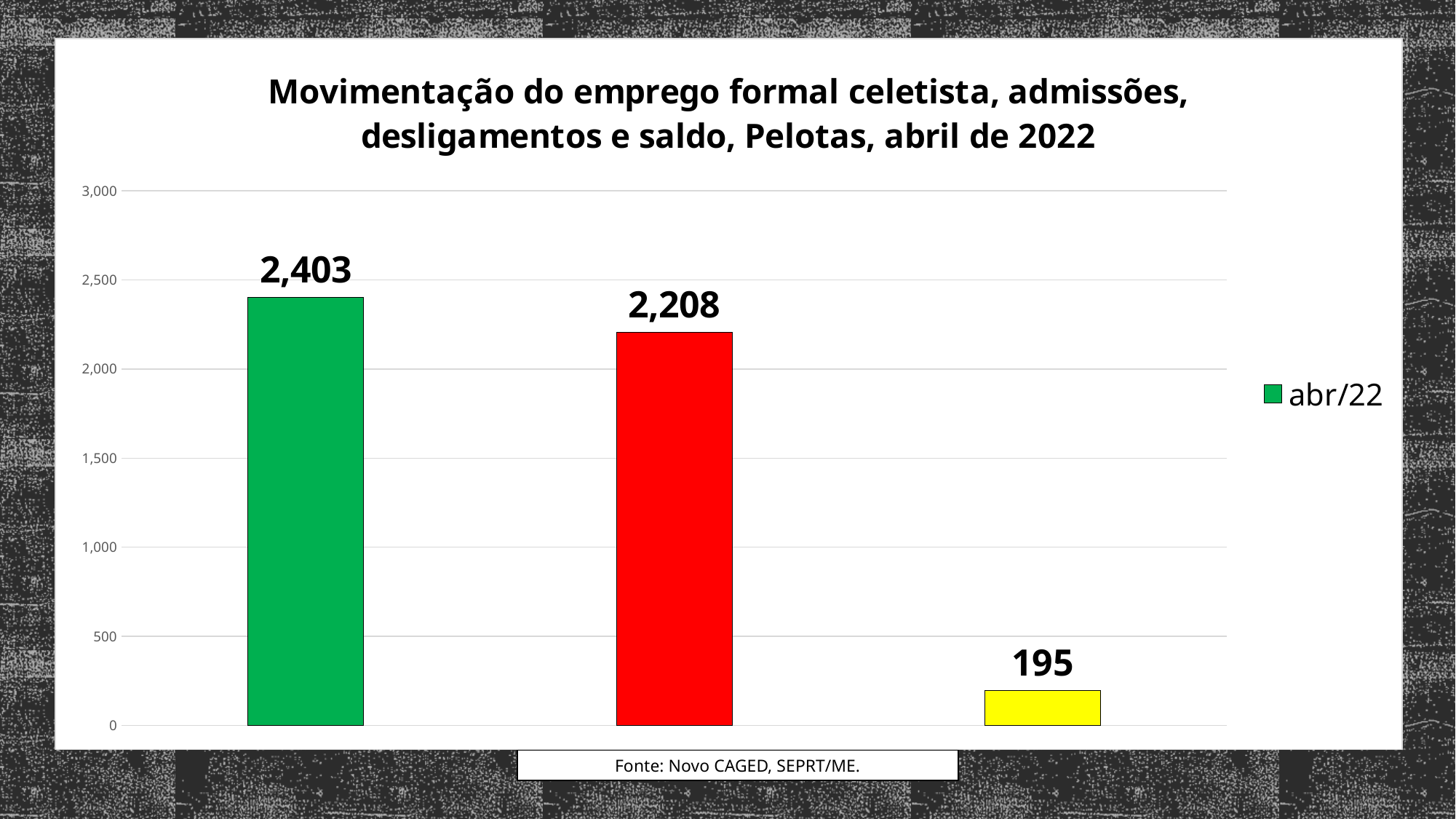
Which bar has the highest value: the green, red or yellow bar? green How many bars are plotted in the chart? 3 Is the value of the yellow bar greater or less than 500? less What is the value shown on the green bar (the first bar from the left)? 2,403 Which is larger, the value of the green bar or the value of the red bar? green bar Which bar has the lowest value: the green, red or yellow bar? yellow What is the value shown on the yellow bar (the rightmost bar)? 195 What is the value shown on the red bar (the middle bar)? 2,208 How many series does the legend list? 1 What kind of chart is shown on the slide? bar chart What is the difference between the value of the red bar and the value of the yellow bar? 2,013 What is the difference between the value of the green bar and the value of the red bar? 195